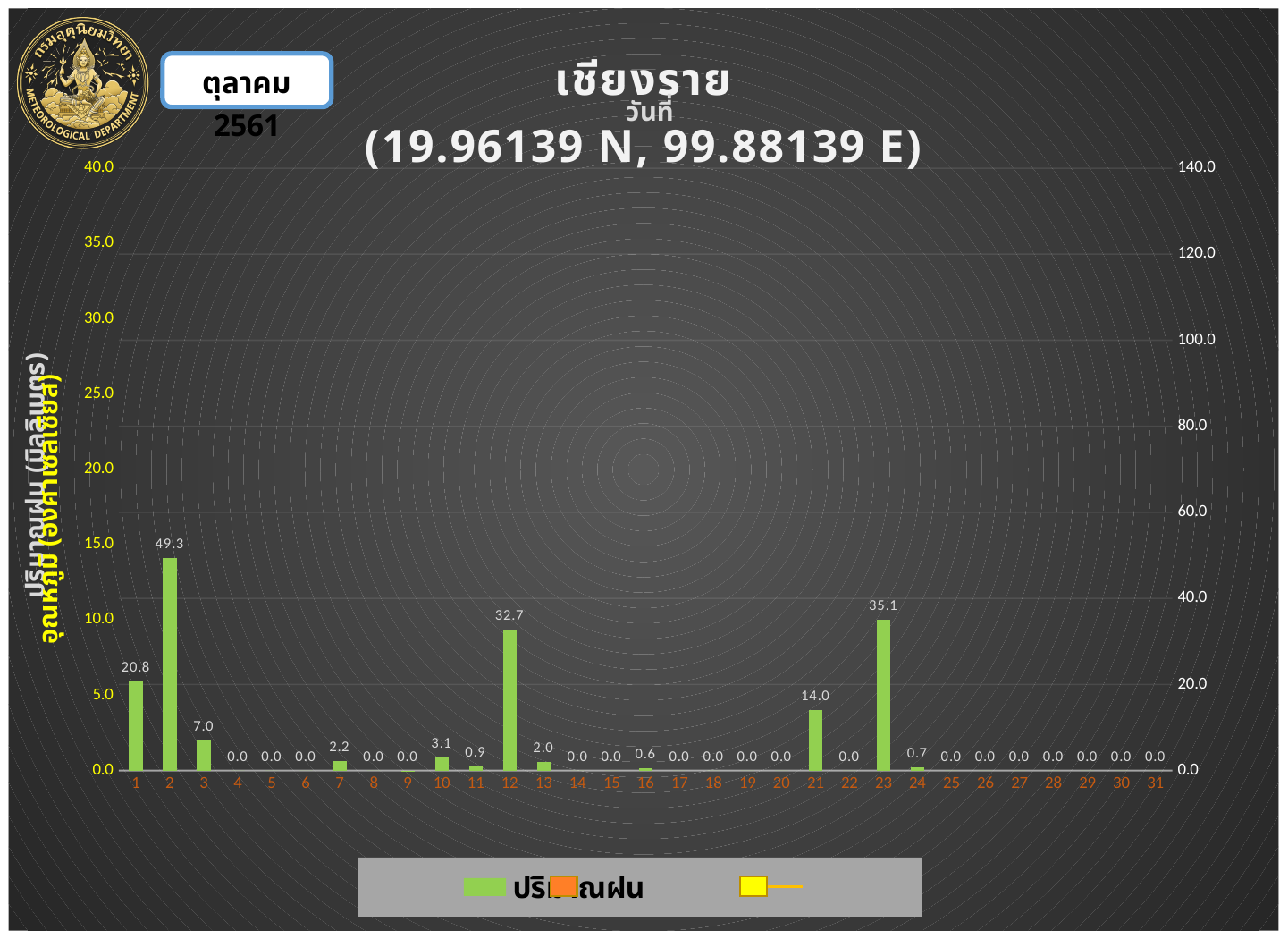
What is the rainfall value shown for day 10? 3.1 What is the difference between the rainfall values for day 2 and day 23? 14.2 What is the rainfall value shown for day 2? 49.3 What is the rainfall value shown for day 21? 14.0 What is the difference between the rainfall values for day 1 and day 3? 13.8 Which day has the larger rainfall value, day 12 or day 23? 23 What is the main title of the chart? เชียงราย What is the rainfall value shown for day 23? 35.1 What is the rainfall value shown for day 12? 32.7 How many days are shown on the x axis? 31 What kind of chart is used to show the rainfall values? bar chart Which day has the highest rainfall value? 2